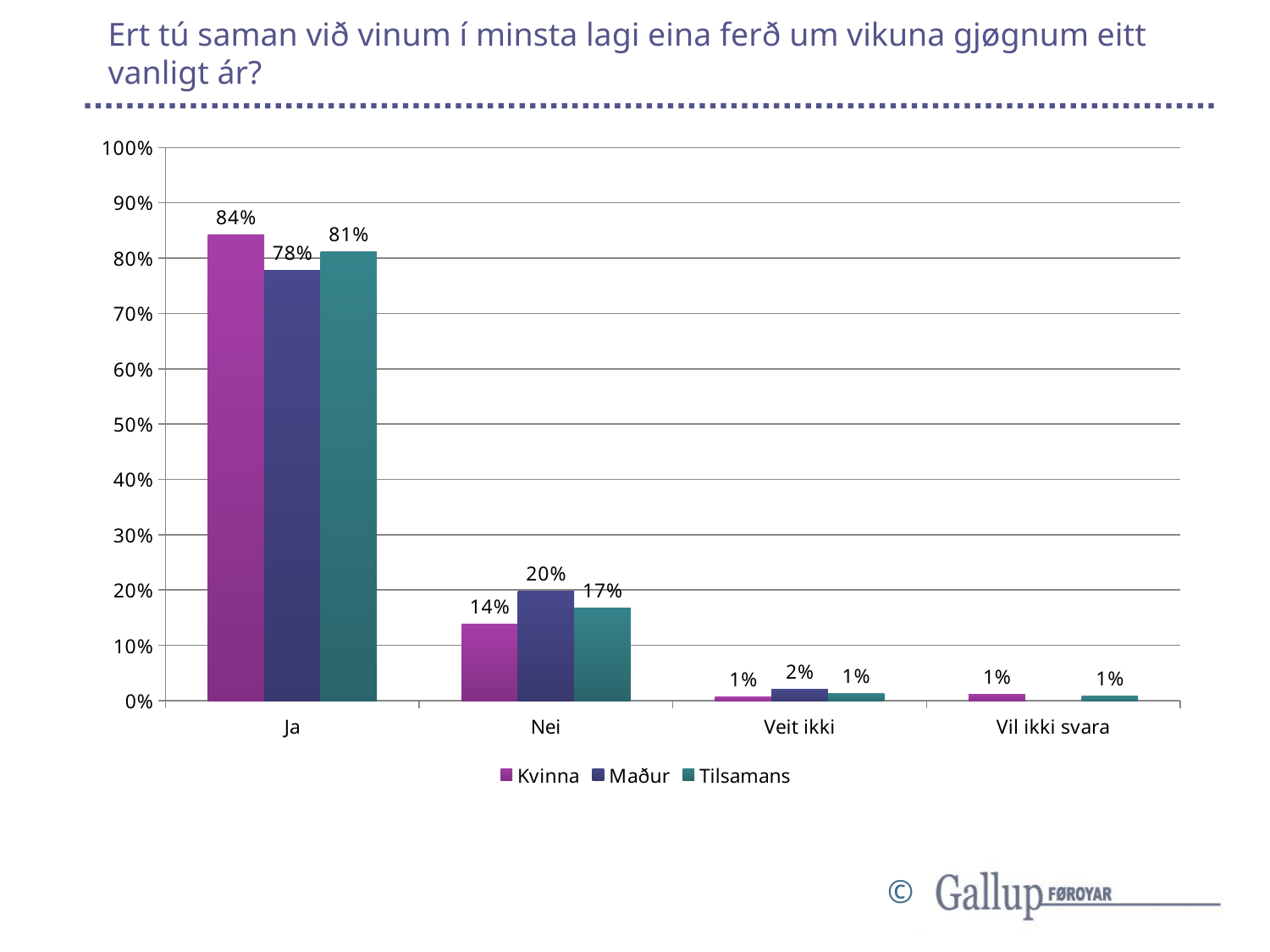
How many categories are shown on the x axis? 4 What kind of chart is shown on the slide? Bar chart What is the value for Kvinna in the Ja category? 84% What is the value for Maður in the Nei category? 20% Which is larger in the Nei category, Kvinna or Tilsamans? Tilsamans How many series does the legend list? 3 What is the value for Maður in the Veit ikki category? 2% What is the value for Tilsamans in the Ja category? 81% Which category has the highest value for Tilsamans? Ja What is the difference between the Maður and Kvinna values in the Nei category? 6% Which series is shown in teal in the legend? Tilsamans What is the difference between the Kvinna and Maður values in the Ja category? 6%